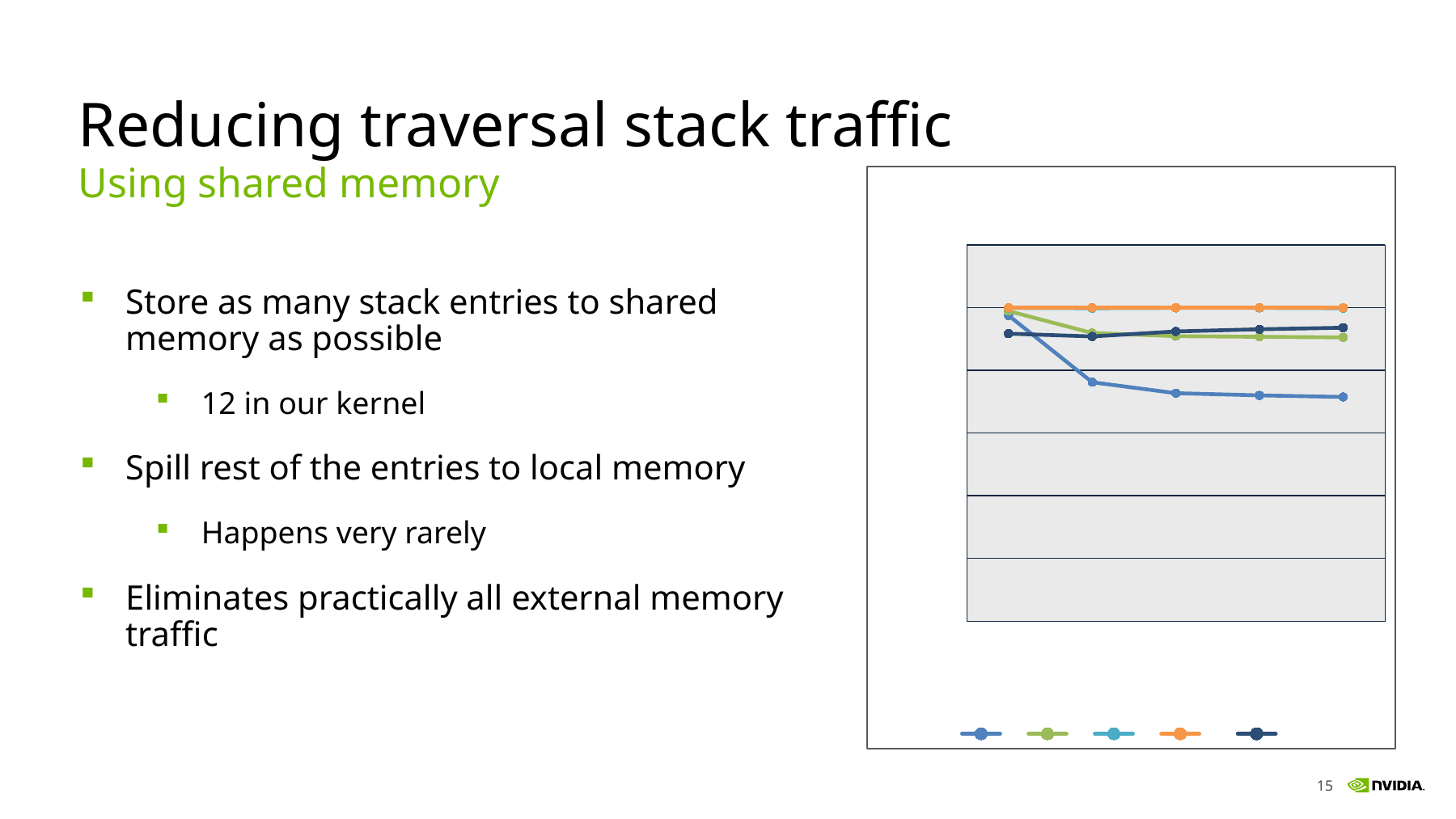
Which coloured line is highest on the chart? orange How many data points does the orange line have? 5 Does the orange line rise, fall, or stay flat from left to right? stay flat Does the chart display any axis labels or data labels? No Which coloured line is lowest at the right-hand end of the chart? blue How many series does the legend below the chart list? 5 What kind of chart is shown on the slide? line chart Does the blue line rise or fall from left to right? fall At the right-hand end of the chart, is the orange line or the blue line higher? orange